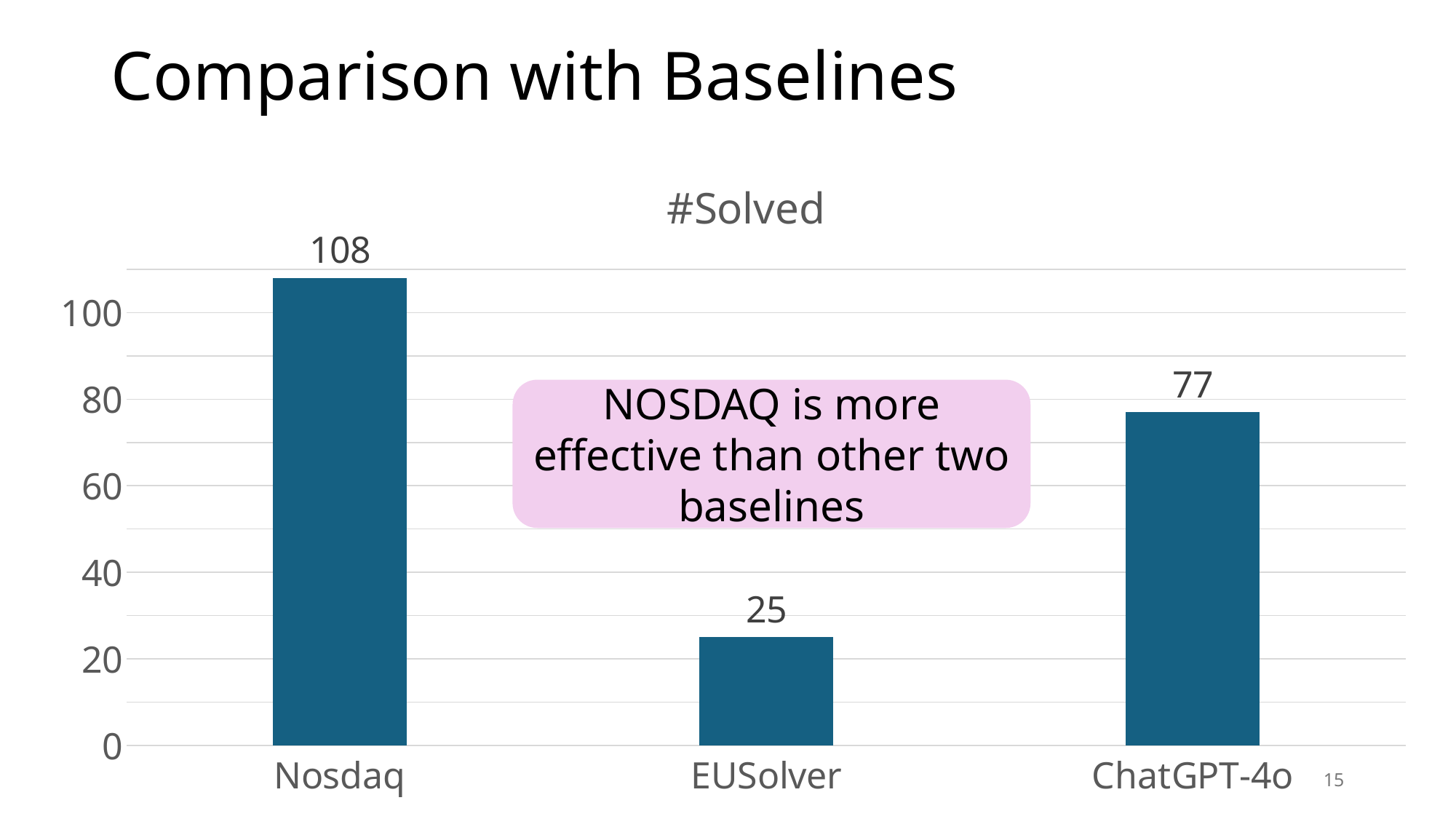
Which category has the lowest #Solved value? EUSolver Is the value for ChatGPT-4o greater or less than 80? less Which has a larger #Solved value, EUSolver or ChatGPT-4o? ChatGPT-4o What is the title of the chart? #Solved What is the #Solved value for ChatGPT-4o? 77 Which category has the highest #Solved value? Nosdaq What is the difference between the #Solved values for ChatGPT-4o and EUSolver? 52 How many categories are shown in the chart? 3 What is the difference between the #Solved values for Nosdaq and ChatGPT-4o? 31 What is the #Solved value for Nosdaq? 108 What kind of chart is shown on the slide? bar chart What is the #Solved value for EUSolver? 25